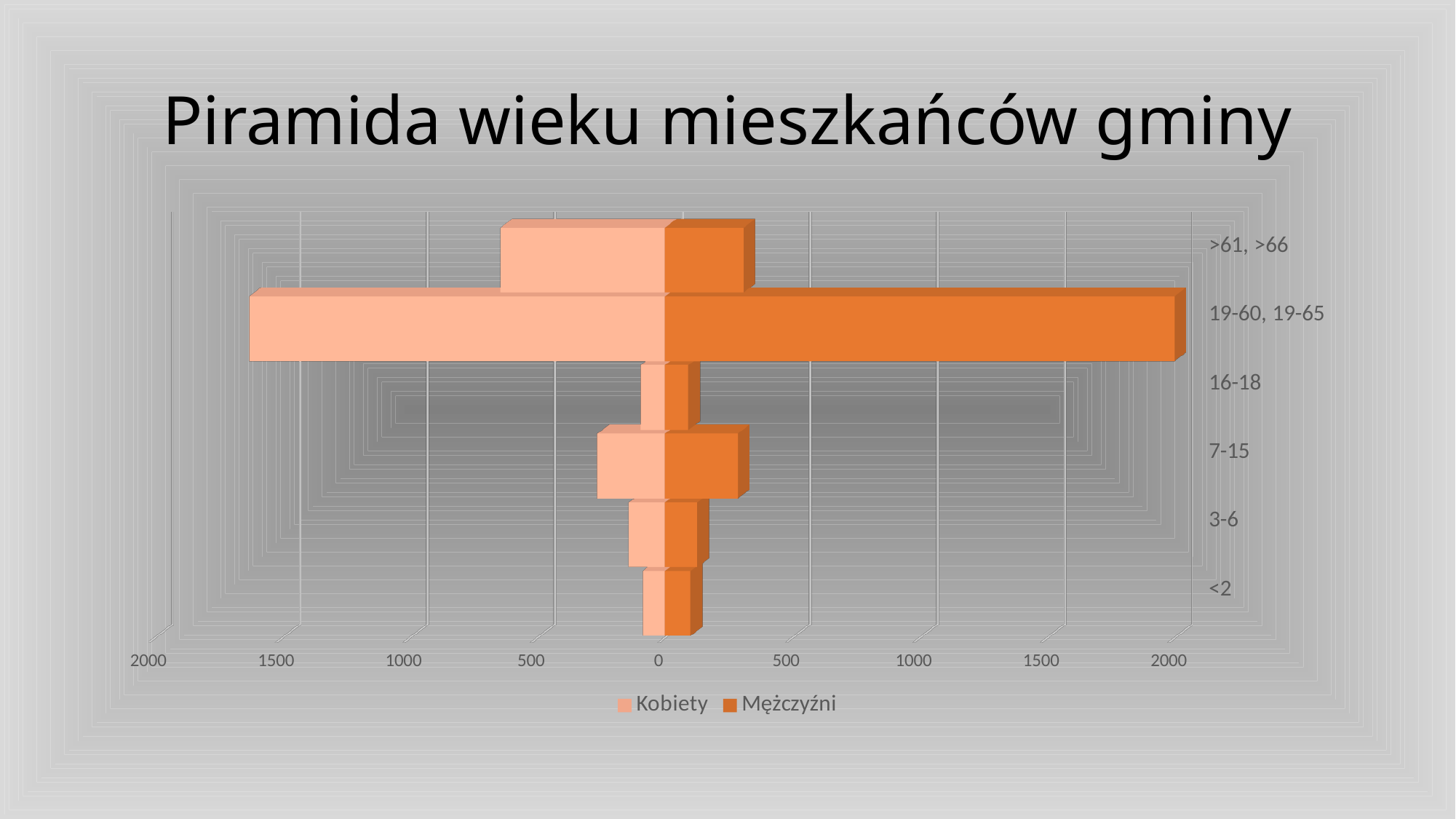
Which age category has the highest value for Mężczyźni? 19-60, 19-65 How many age categories are shown on the chart? 6 How many series does the legend list? 2 What kind of chart is shown on the slide? bar chart In the 19-60, 19-65 category, which series has the larger value, Kobiety or Mężczyźni? Mężczyźni Which age category has the highest value for Kobiety? 19-60, 19-65 Is the value for Mężczyźni in the >61, >66 category greater or less than 500? less Is the value for Kobiety in the 19-60, 19-65 category greater or less than 1500? greater What is the title of the chart? Piramida wieku mieszkańców gminy In the >61, >66 category, which series has the larger value, Kobiety or Mężczyźni? Kobiety What are the two series named in the legend? Kobiety and Mężczyźni Is the value for Kobiety in the >61, >66 category greater or less than 500? greater